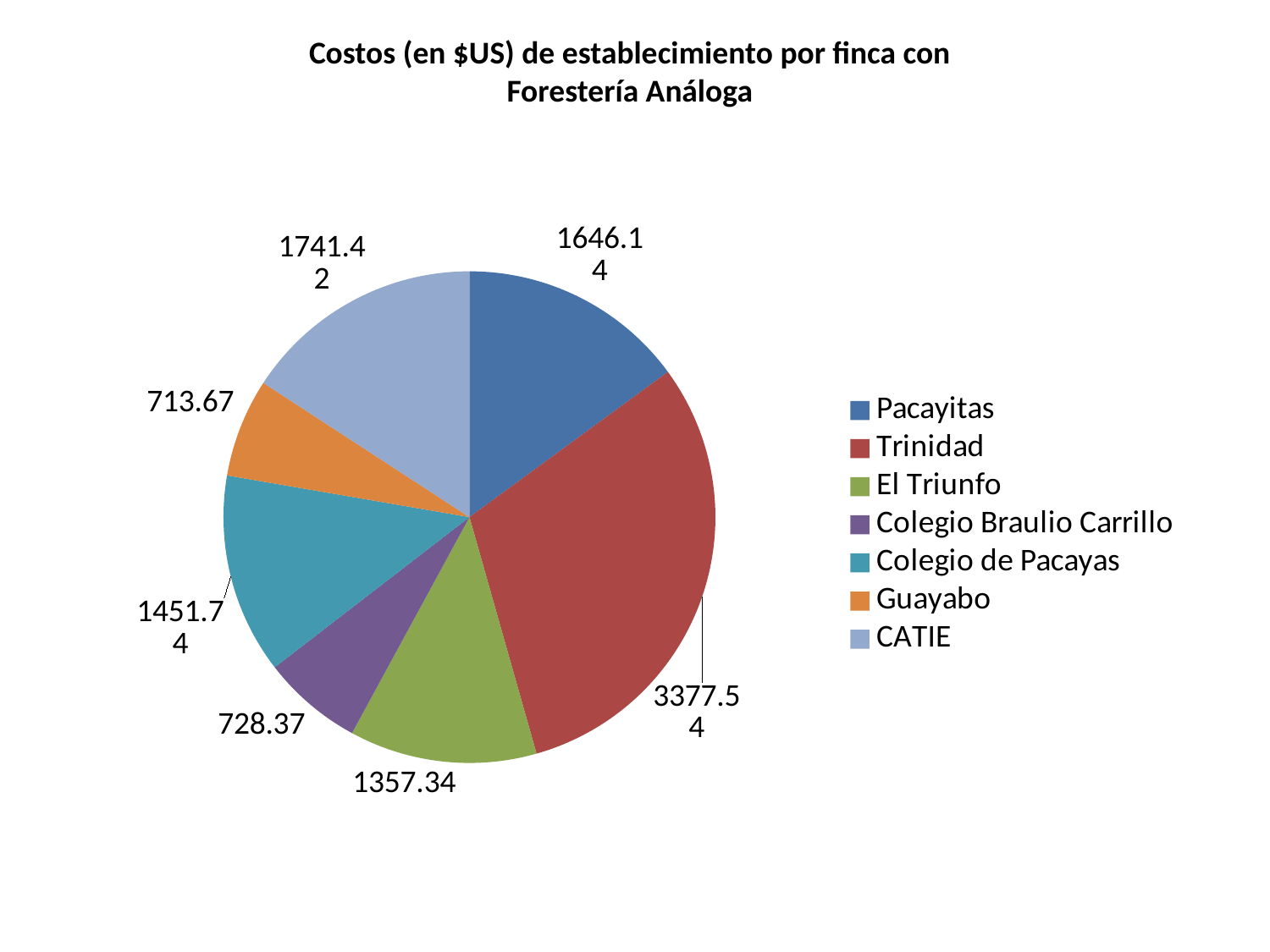
How many fincas are shown in the pie chart? 7 Which finca has the lowest establishment cost? Guayabo What type of chart is shown on the slide? Pie chart What is the difference between the establishment costs of Trinidad and Pacayitas? 1731.40 What is the establishment cost for El Triunfo? 1357.34 Which has a larger establishment cost, Pacayitas or El Triunfo? Pacayitas What is the establishment cost for Colegio de Pacayas? 1451.74 What is the establishment cost for Trinidad? 3377.54 Which finca has the highest establishment cost? Trinidad What is the establishment cost for CATIE? 1741.42 What is the title of the chart? Costos (en $US) de establecimiento por finca con Forestería Análoga What is the difference between the establishment costs of CATIE and Guayabo? 1027.75